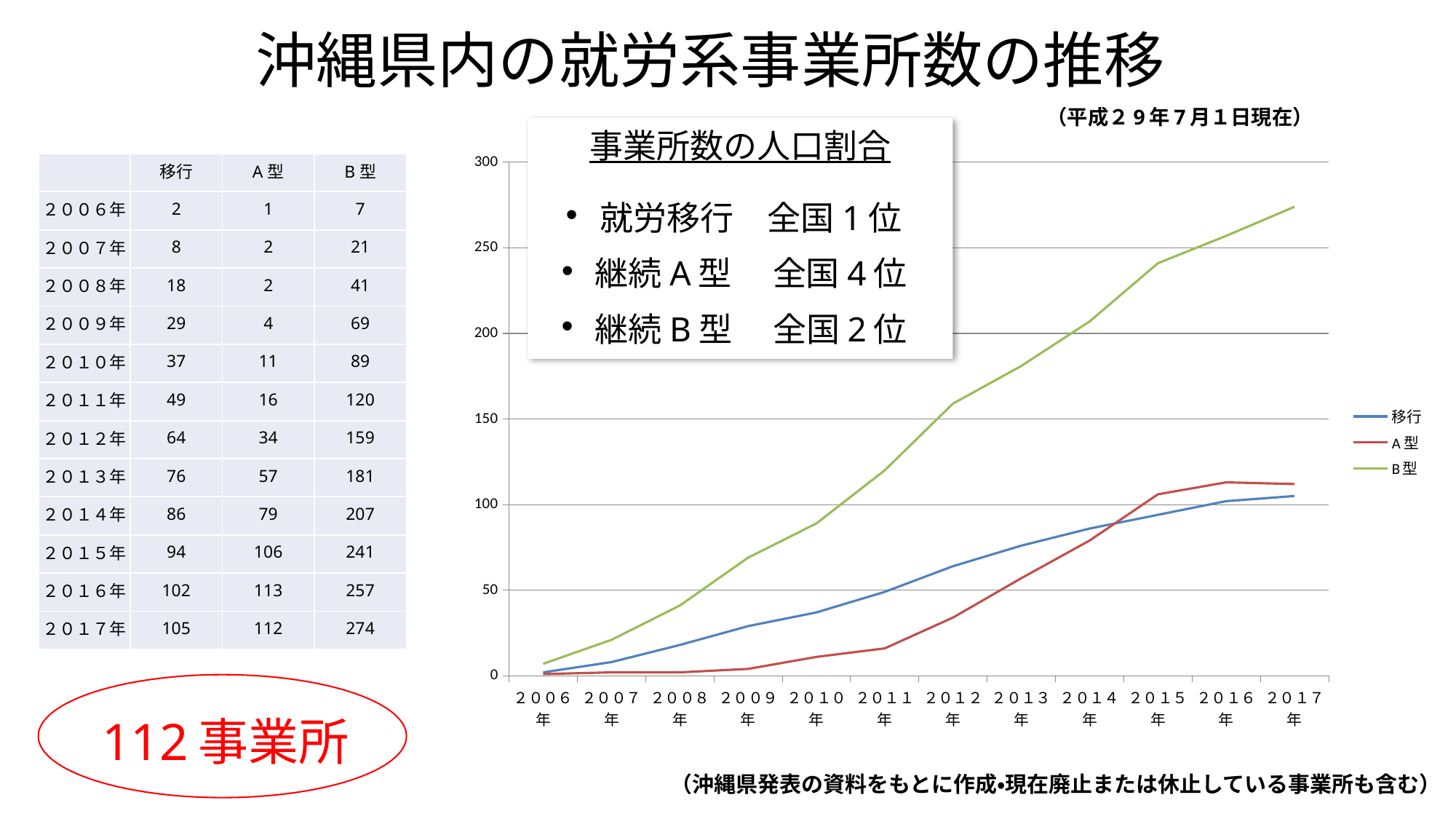
Which series has the lowest value in 2010? A型 Is the value for 移行 in 2016 greater or less than 100? greater Which series has the highest value in 2017? B型 In 2013, which is larger, the value for 移行 or the value for A型? 移行 Does the B型 line rise or fall from 2006 to 2017? rises According to the table on the slide, what is the value for B型 in 2015? 241 How many series does the chart legend list? 3 What colour is the line for B型 in the chart? green Is the value for B型 in 2017 greater or less than 250? greater Is the value for A型 in 2012 greater or less than 50? less What kind of chart is shown on the slide? line chart How many years are plotted along the x axis of the chart? 12